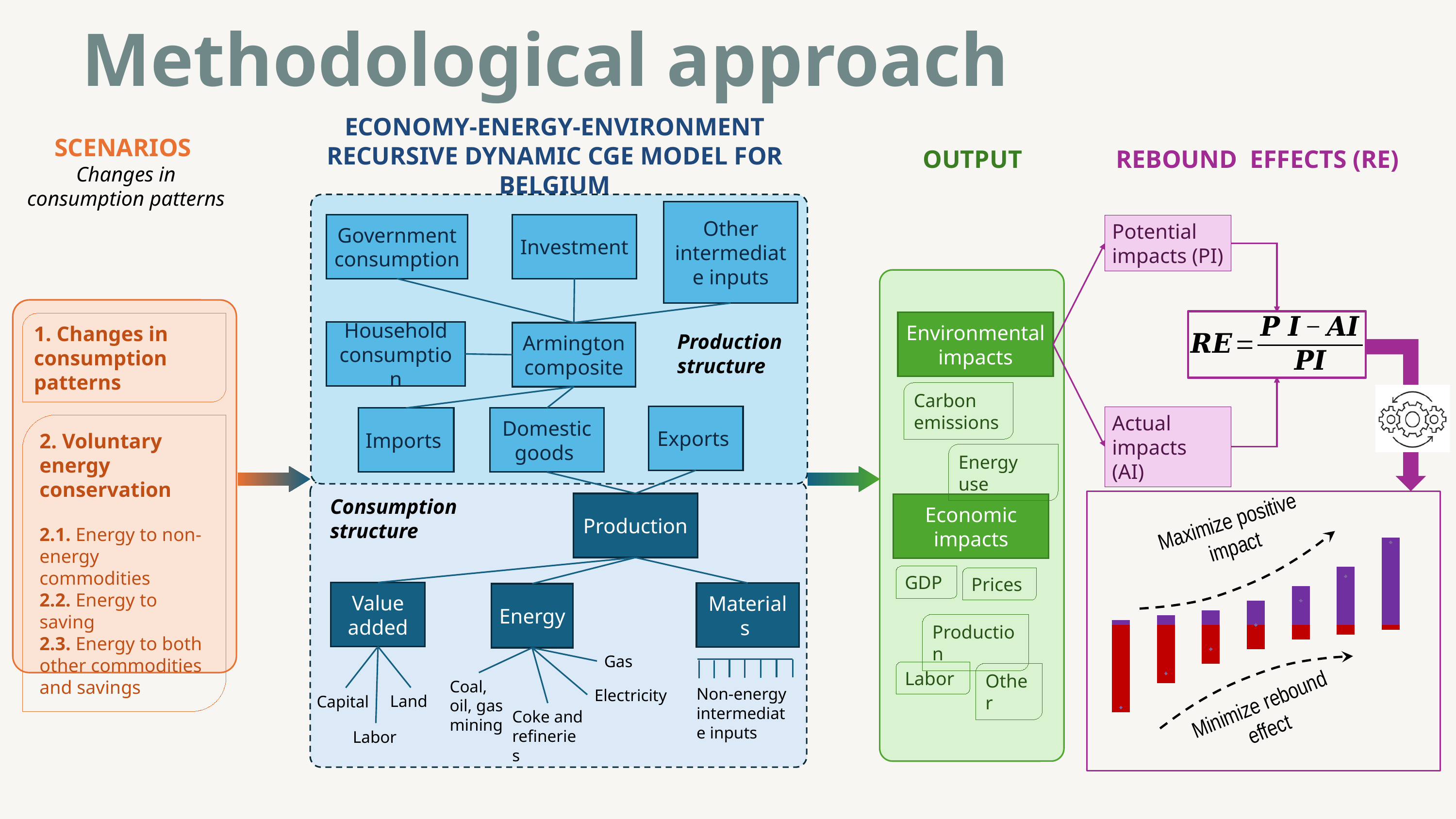
How many bars are plotted in the bottom-right rebound effects chart? 7 In the bottom-right rebound effects chart, which bar has the largest purple segment, the leftmost or the rightmost? Rightmost In the bottom-right rebound effects chart, do the purple segments rise or fall from left to right? Rise What does the dashed arrow above the bars in the bottom-right rebound effects chart say? Maximize positive impact What two colours are used for the bar segments in the bottom-right rebound effects chart? Red and purple In the bottom-right rebound effects chart, which bar has the largest red segment, the leftmost or the rightmost? Leftmost What kind of chart is shown in the bottom-right box under REBOUND EFFECTS (RE)? Stacked bar chart